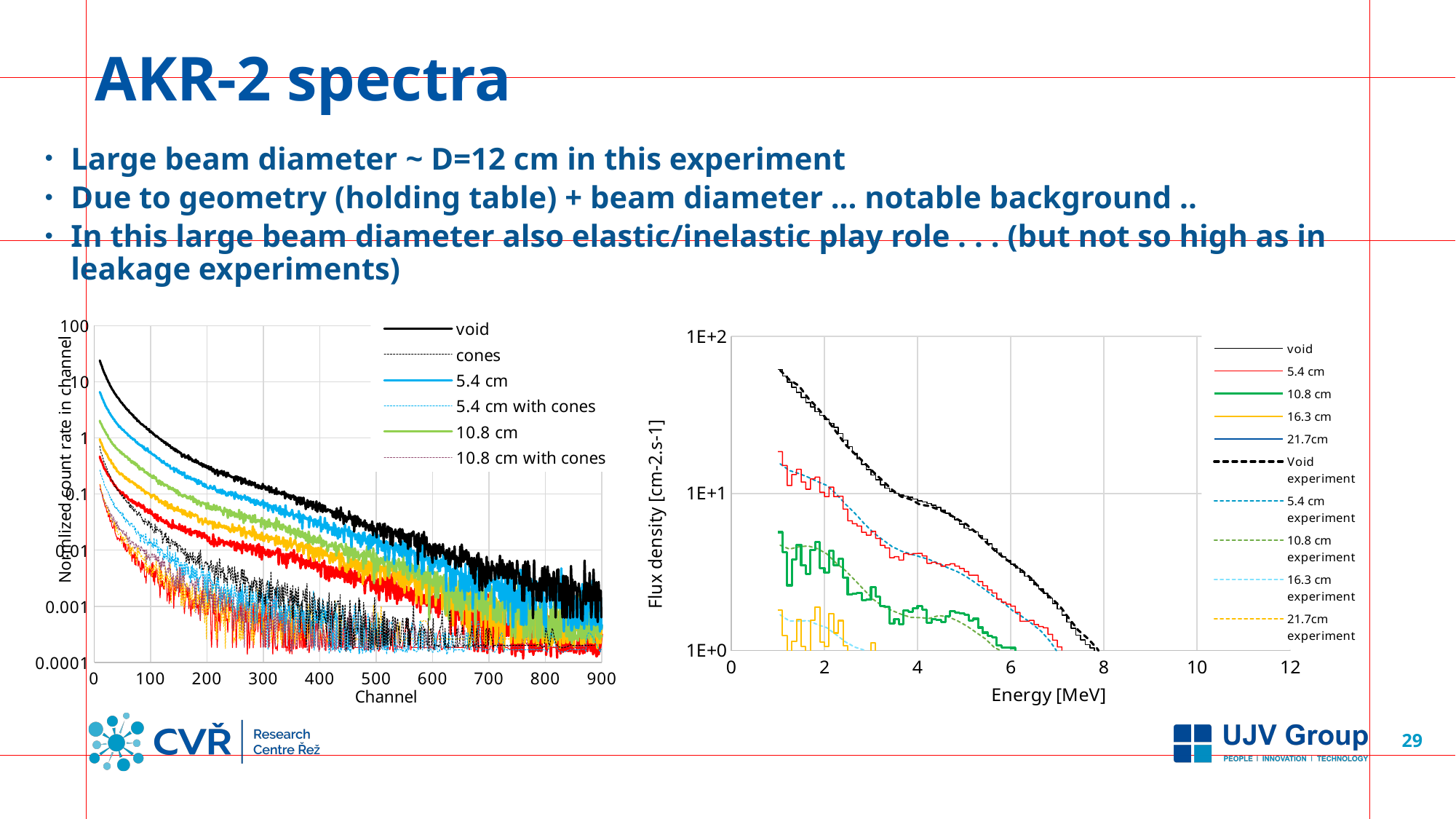
What kind of chart is the left chart (count rate vs channel)? line chart In the right chart, which series has the highest flux density? void In the right chart, is the flux density of the void series at 2 MeV greater or less than 1E+1? greater In the left chart, which series has the highest count rate across the channels? void What kind of chart is the right chart (flux density vs energy)? line chart In the left chart, is the void count rate at channel 500 greater or less than 0.01? greater What is the x-axis label of the right chart? Energy [MeV] How many series does the legend of the right chart list? 10 In the right chart, does the flux density for the void series rise or fall as energy increases? fall How many series does the legend of the left chart list? 6 What is the x-axis label of the left chart? Channel In the left chart, do the count rate values rise or fall as the channel number increases? fall